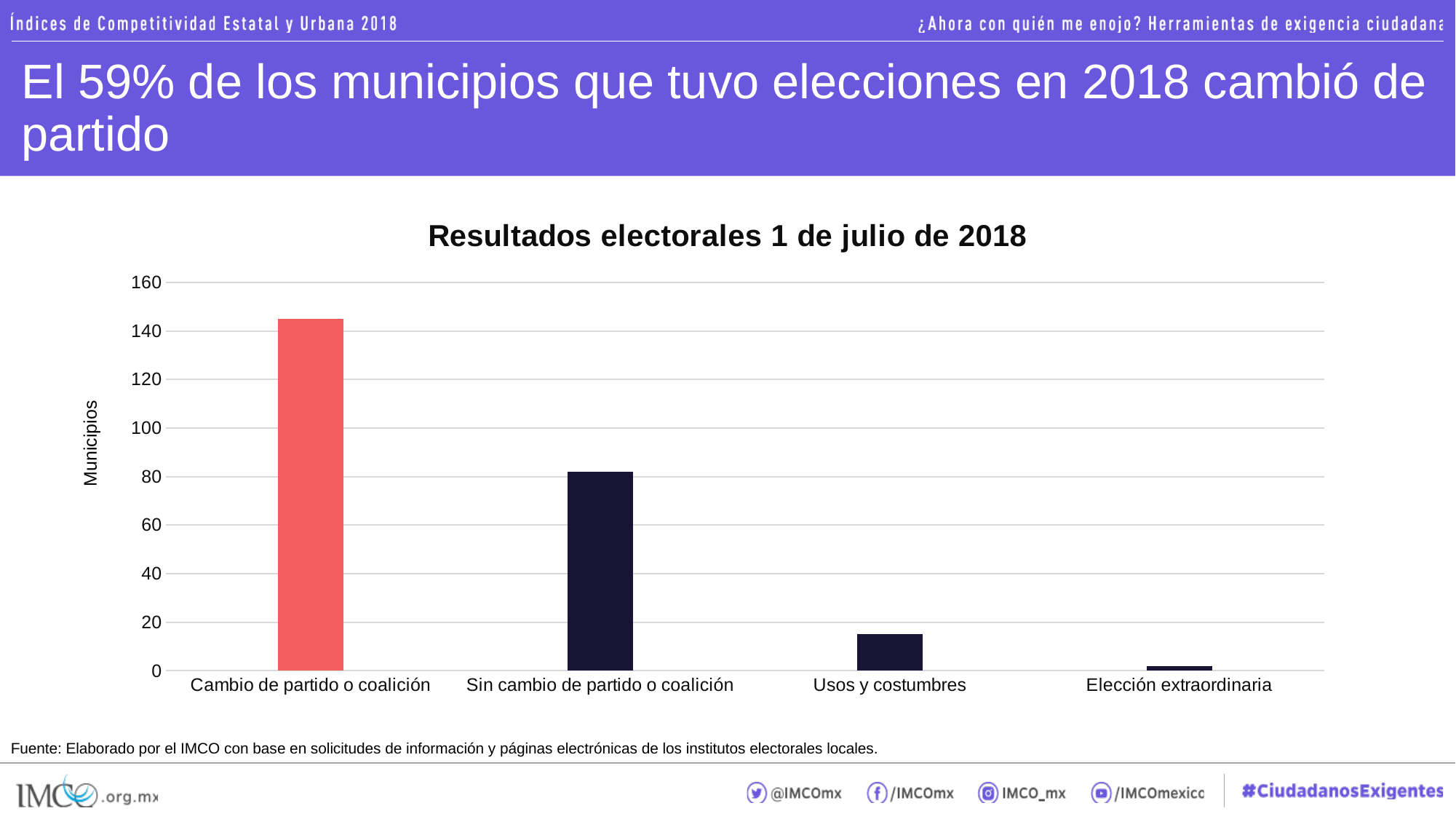
Is the value for Cambio de partido o coalición greater or less than 120? greater How many categories are shown on the x axis? 4 Which category has the highest number of municipios? Cambio de partido o coalición Is the value for Sin cambio de partido o coalición greater or less than 100? less Is the value for Sin cambio de partido o coalición greater or less than 60? greater Which category has the lowest number of municipios? Elección extraordinaria Which is larger, the value for Sin cambio de partido o coalición or the value for Usos y costumbres? Sin cambio de partido o coalición What kind of chart is shown on the slide? bar chart What is the title of the chart? Resultados electorales 1 de julio de 2018 What is the label of the vertical axis? Municipios Do the values rise or fall from left to right along the x axis? fall